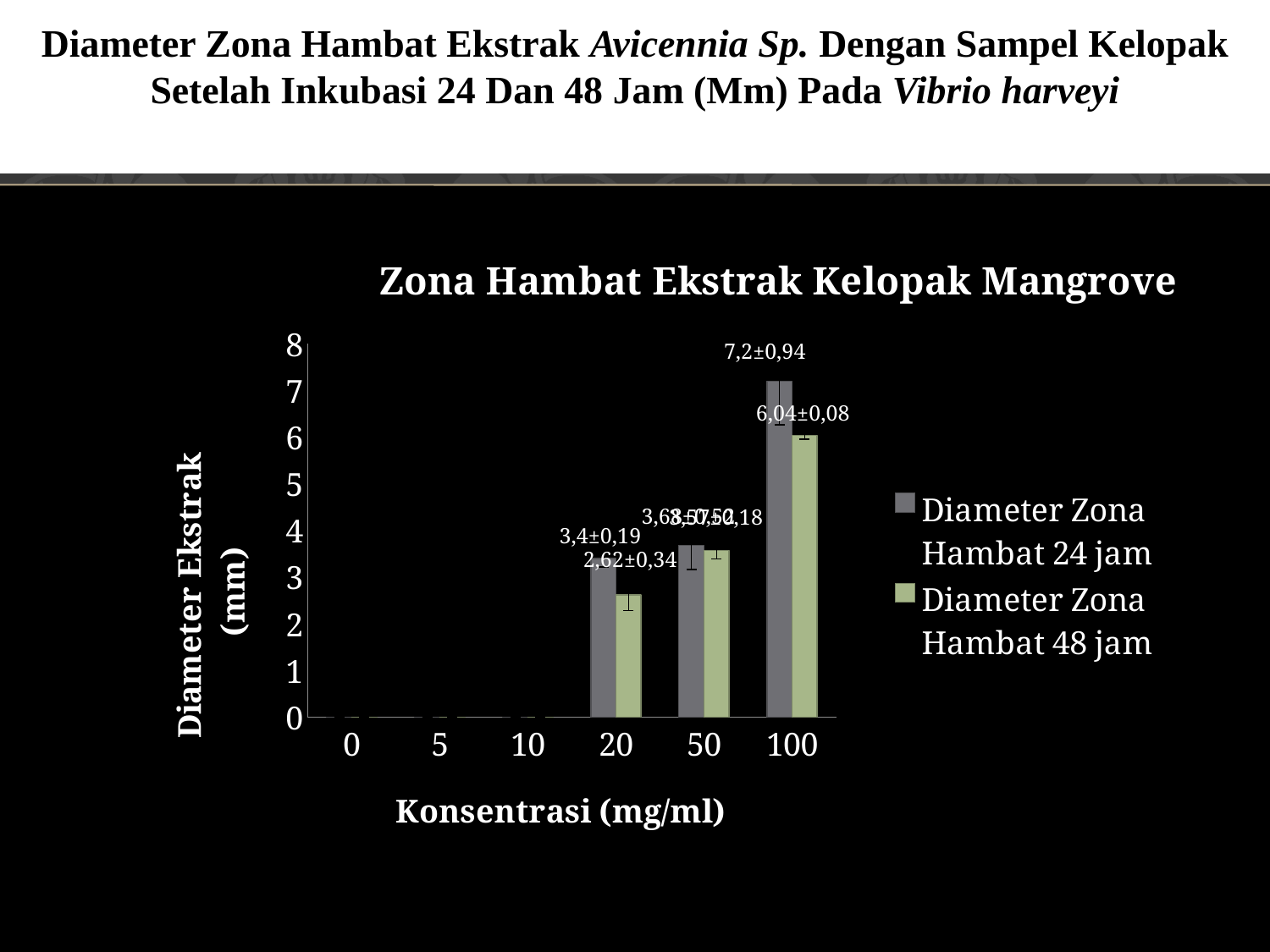
At a concentration of 100 mg/ml, which is larger: Diameter Zona Hambat 24 jam or Diameter Zona Hambat 48 jam? Diameter Zona Hambat 24 jam How many series does the legend list? 2 What is the Diameter Zona Hambat 48 jam value at a concentration of 100 mg/ml? 6,04±0,08 What is the title of the x axis? Konsentrasi (mg/ml) What kind of chart is shown on the slide? bar chart How many concentration categories are shown on the x axis? 6 At which concentration is the Diameter Zona Hambat 24 jam highest? 100 What is the Diameter Zona Hambat 24 jam value at a concentration of 100 mg/ml? 7,2±0,94 Is the Diameter Zona Hambat 48 jam value at 50 mg/ml greater or less than 3? greater Do the Diameter Zona Hambat 24 jam values rise or fall as concentration increases from 20 to 100 mg/ml? rise What is the Diameter Zona Hambat 24 jam value at a concentration of 20 mg/ml? 3,4±0,19 What is the Diameter Zona Hambat 48 jam value at a concentration of 20 mg/ml? 2,62±0,34